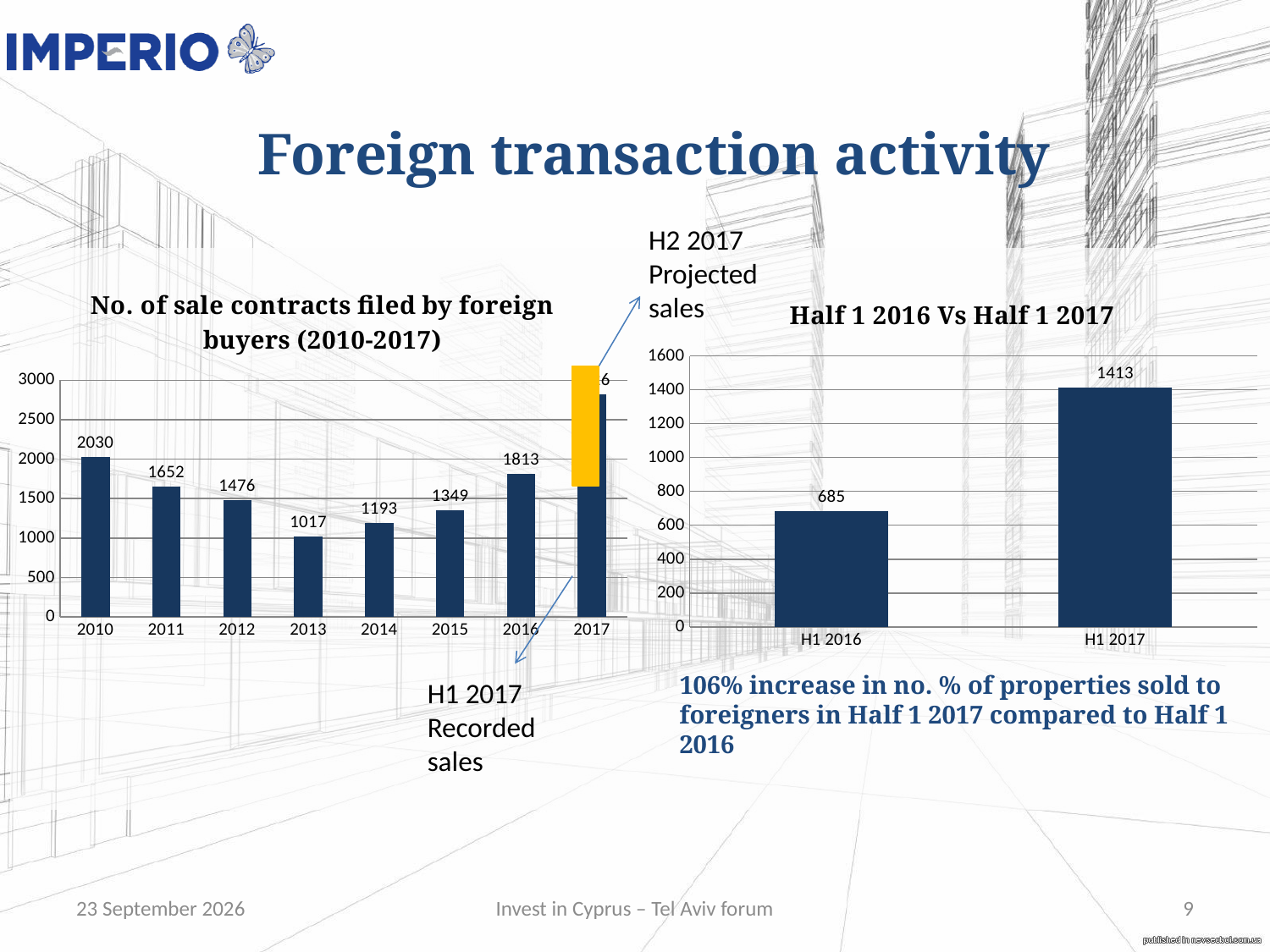
In the chart titled "No. of sale contracts filed by foreign buyers (2010-2017)", what is the difference between the values for 2010 and 2011? 378 In the chart titled "No. of sale contracts filed by foreign buyers (2010-2017)", what is the value for 2010? 2030 In the chart titled "No. of sale contracts filed by foreign buyers (2010-2017)", do the values rise or fall from 2010 to 2013? fall In the chart titled "Half 1 2016 Vs Half 1 2017", what is the difference between the values for H1 2017 and H1 2016? 728 In the chart titled "Half 1 2016 Vs Half 1 2017", what is the value for H1 2016? 685 In the chart titled "No. of sale contracts filed by foreign buyers (2010-2017)", how many years are shown on the x axis? 8 In the chart titled "No. of sale contracts filed by foreign buyers (2010-2017)", which year has the lowest value? 2013 In the chart titled "No. of sale contracts filed by foreign buyers (2010-2017)", which is larger, the value for 2014 or the value for 2015? 2015 In the chart titled "Half 1 2016 Vs Half 1 2017", what is the value for H1 2017? 1413 In the chart titled "No. of sale contracts filed by foreign buyers (2010-2017)", is the value for 2017 greater or less than 2500? greater What kind of chart is the chart titled "Half 1 2016 Vs Half 1 2017"? bar chart In the chart titled "No. of sale contracts filed by foreign buyers (2010-2017)", what is the value for 2013? 1017